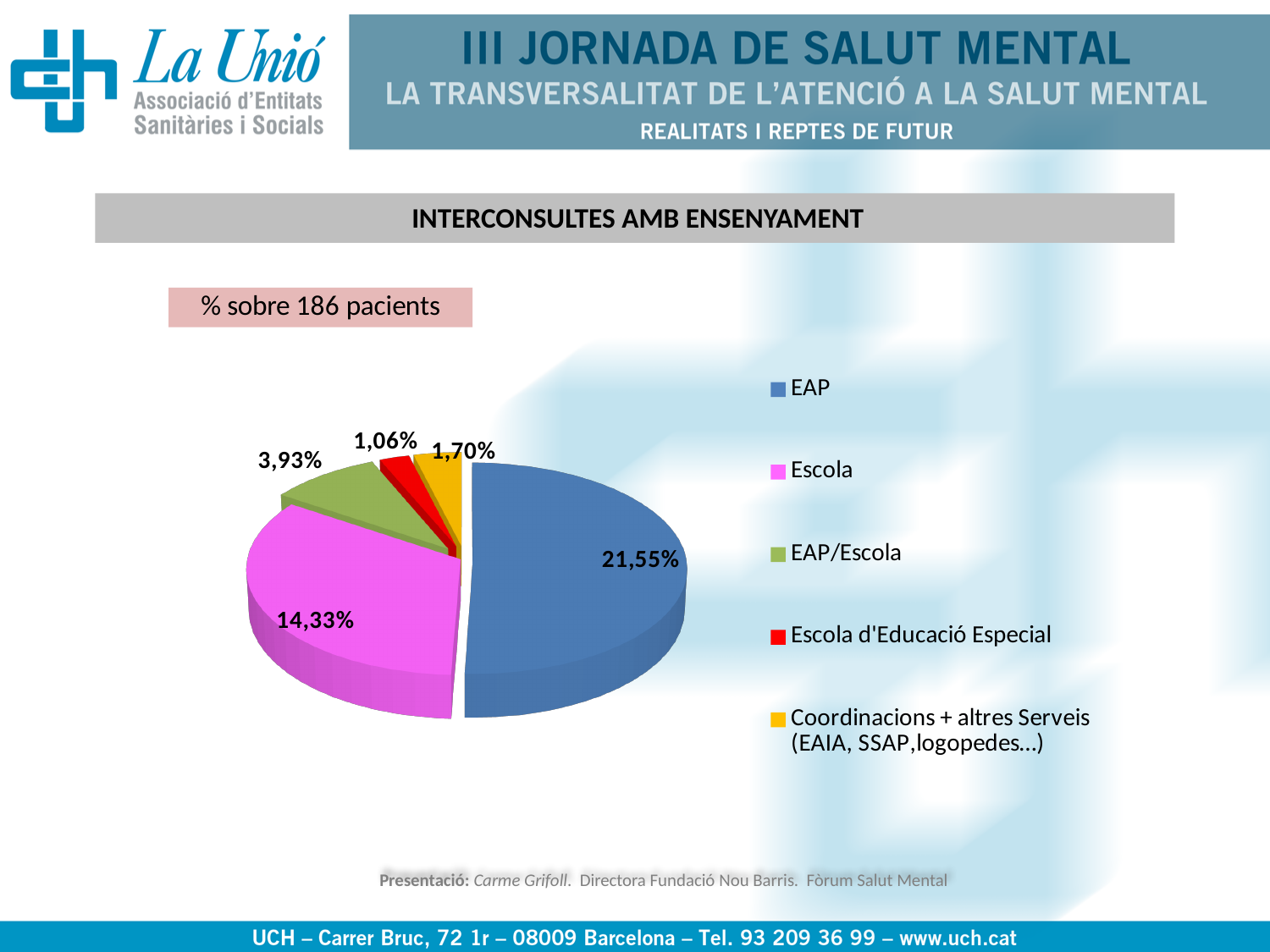
What is the value shown for Coordinacions + altres Serveis (EAIA, SSAP, logopedes...)? 1,70% What kind of chart is shown on the slide? Pie chart How many categories does the legend list? 5 Which category has the largest slice of the pie? EAP What colour is the slice for Escola? Pink What is the value shown for Escola? 14,33% What is the difference between the values for EAP and Escola? 7,22% What is the value shown for Escola d'Educació Especial? 1,06% Which category has the smallest slice of the pie? Escola d'Educació Especial What is the value shown for EAP? 21,55% What is the value shown for EAP/Escola? 3,93% Which is larger, the value for EAP/Escola or the value for Coordinacions + altres Serveis? EAP/Escola